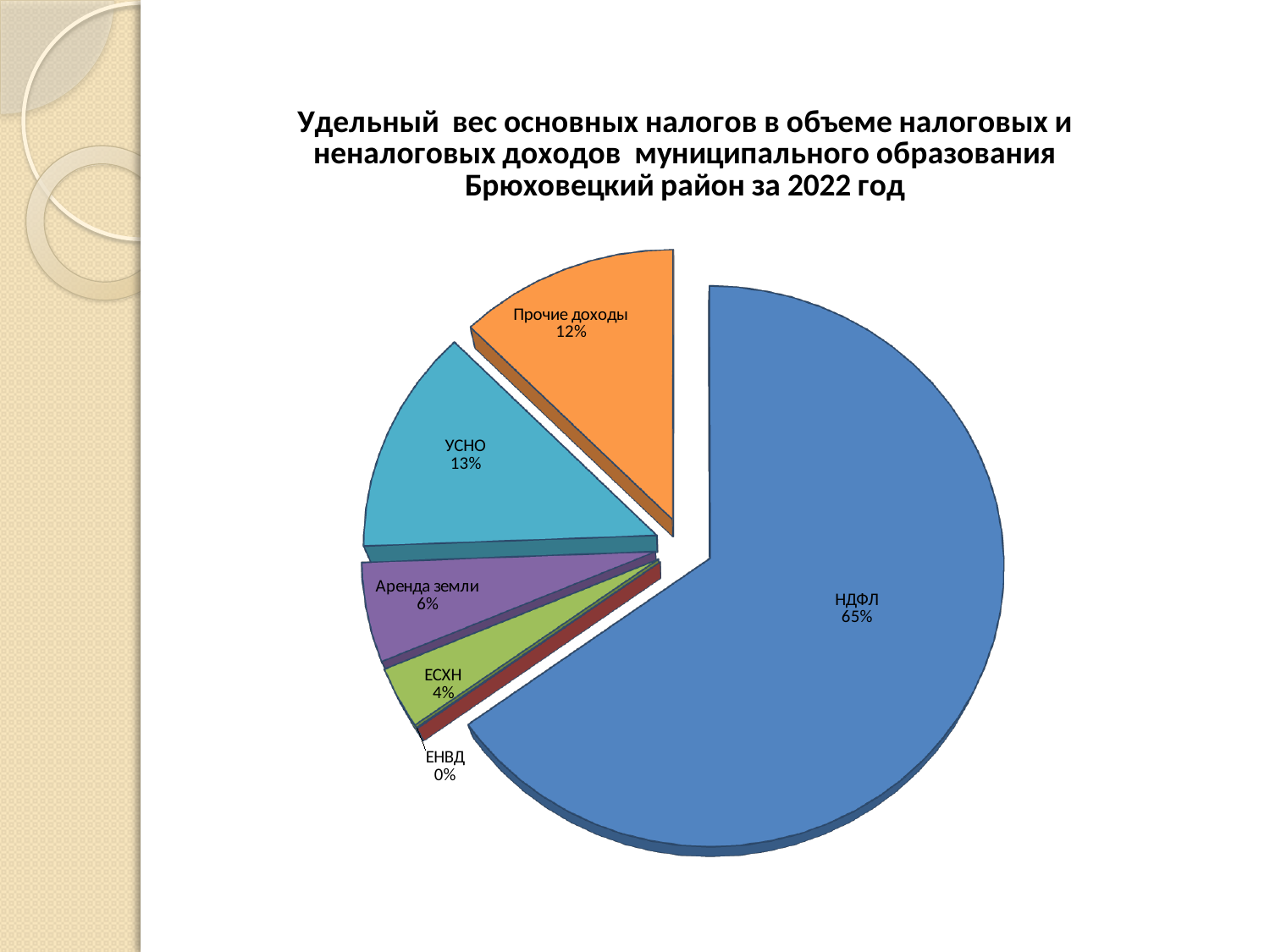
What is the value shown for УСНО? 13% What share of the pie does НДФЛ account for? 65% Which category has the largest share of the pie? НДФЛ What is the difference in percentage points between НДФЛ and УСНО? 52 What is the value shown for Аренда земли? 6% Which is larger, the share for УСНО or the share for Прочие доходы? УСНО Which category has the smallest share of the pie? ЕНВД What is the value shown for Прочие доходы? 12% What is the value shown for ЕНВД? 0% How many categories are shown in the pie chart? 6 What is the value shown for ЕСХН? 4% What kind of chart is shown on the slide? Pie chart